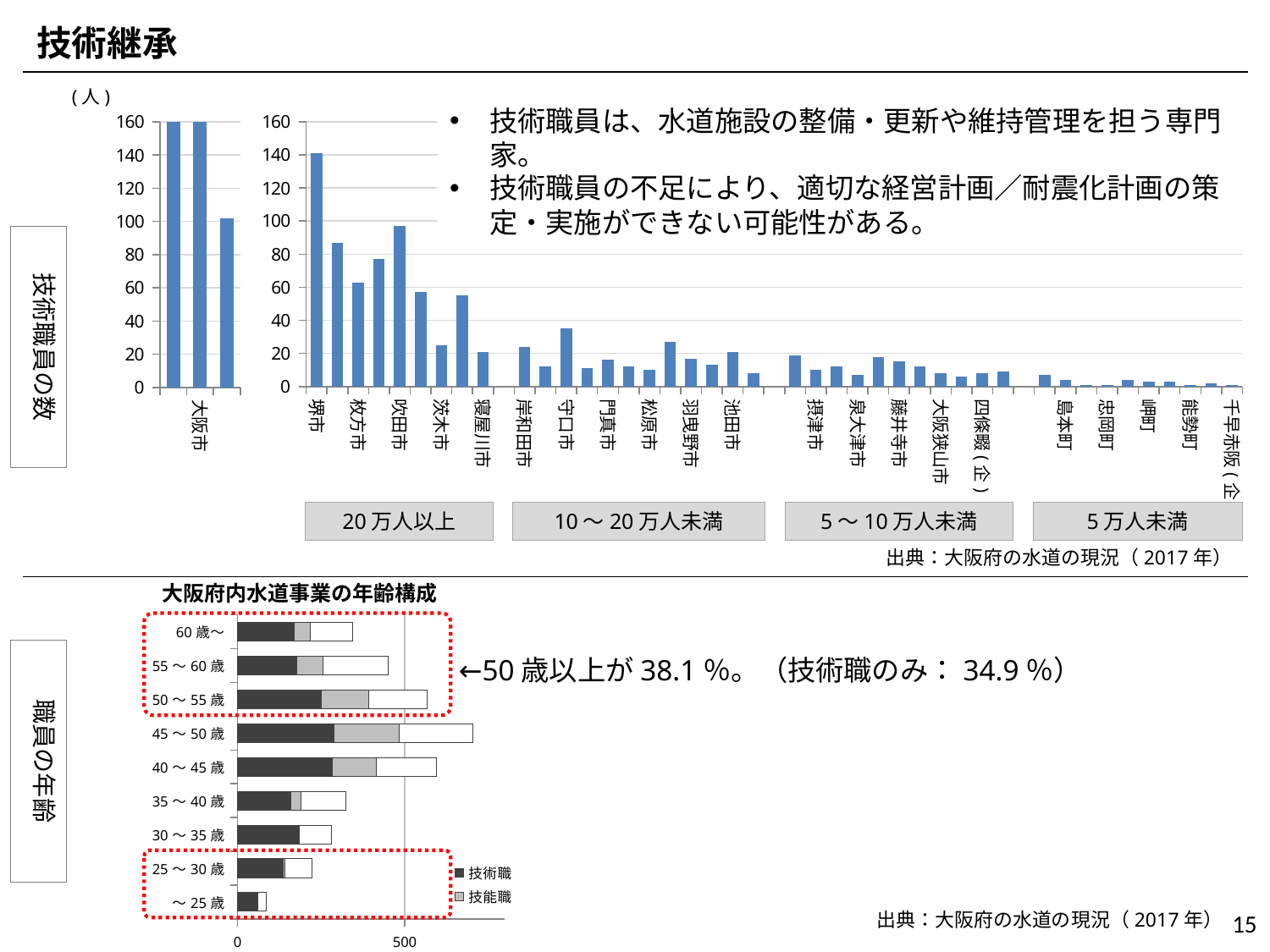
In the top chart (技術職員の数), is the value for 堺市 greater or less than 120? greater What is the title of the bottom chart on the slide? 大阪府内水道事業の年齢構成 What unit is shown at the top left of the top chart (技術職員の数)? (人) In the bottom chart (大阪府内水道事業の年齢構成), which age category has the longest total bar? 45～50歳 How many age categories are shown in the bottom chart (大阪府内水道事業の年齢構成)? 9 In the top chart (技術職員の数), which is larger, the value for 堺市 or the value for 吹田市? 堺市 In the bottom chart (大阪府内水道事業の年齢構成), is the total for ～25歳 greater or less than 500? less What kind of chart is the bottom chart (大阪府内水道事業の年齢構成)? bar chart In the top chart (技術職員の数), is the value for 茨木市 greater or less than 40? less In the top chart (技術職員の数), how many population-size groups are labelled below the x axis? 4 What kind of chart is the top chart showing the number of technical staff (技術職員の数)? bar chart